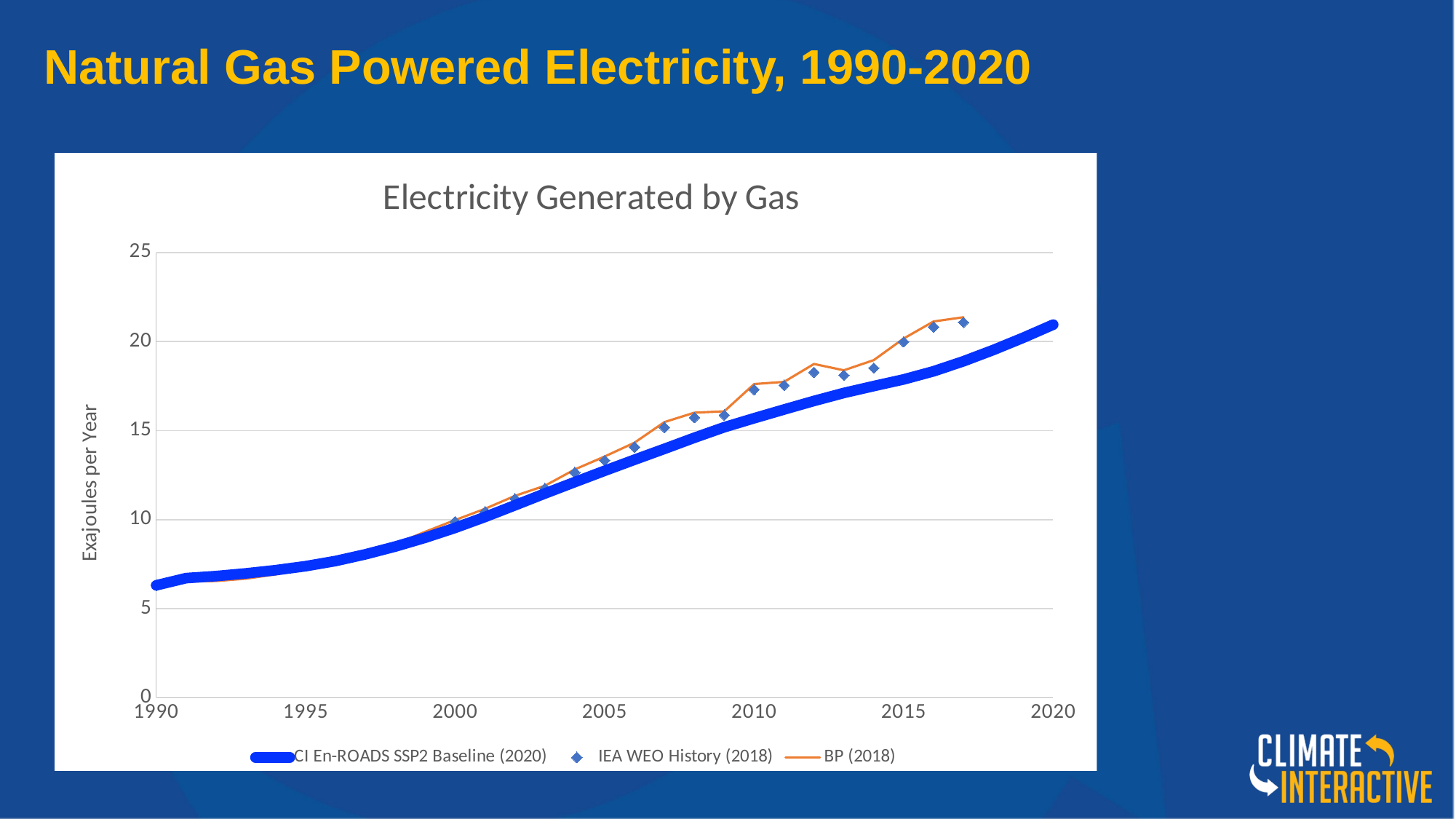
In 2015, which series has the higher value: IEA WEO History (2018) or CI En-ROADS SSP2 Baseline (2020)? IEA WEO History (2018) What is the title of the chart? Electricity Generated by Gas Is the value of the CI En-ROADS SSP2 Baseline (2020) series in 2020 greater or less than 25? less Is the value of the CI En-ROADS SSP2 Baseline (2020) series in 1990 greater or less than 5? greater Is the value of the CI En-ROADS SSP2 Baseline (2020) series in 2010 greater or less than 20? less Does the CI En-ROADS SSP2 Baseline (2020) series rise or fall from 1990 to 2020? rise What is the label on the vertical axis of the chart? Exajoules per Year Does the IEA WEO History (2018) series generally rise or fall from 2000 to 2017? rise How many series does the chart legend list? 3 What kind of chart is shown on the slide? line chart